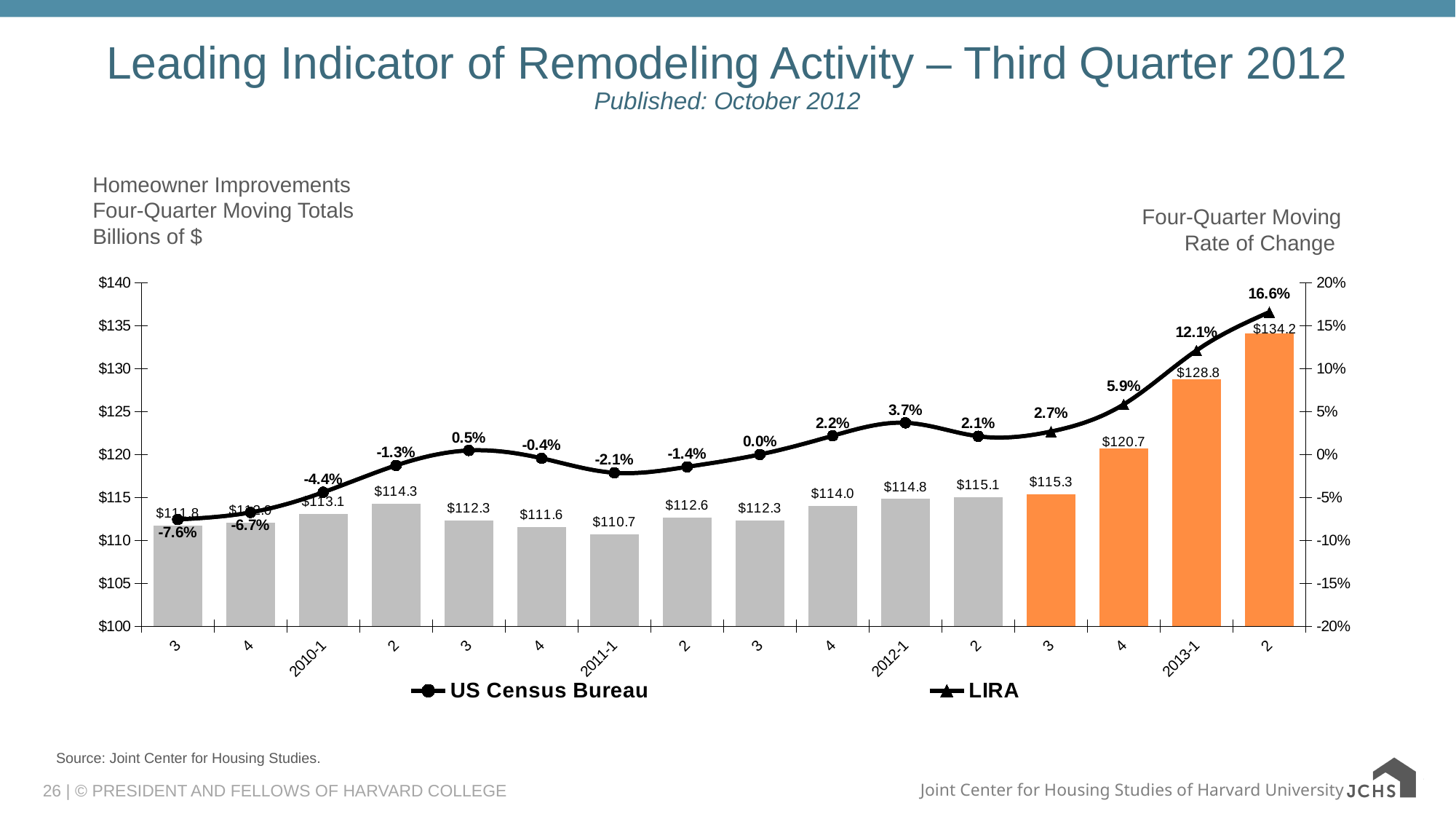
How many series does the legend list? 2 What is the four-quarter moving total shown for 2013-1? $128.8 What four-quarter moving rate of change is labeled at 2012-1? 3.7% What are the two legend entries on the chart? US Census Bureau and LIRA What is the highest four-quarter moving total value labeled on any bar? $134.2 What is the lowest four-quarter moving rate of change labeled on the line? -7.6% Which quarter has the lowest four-quarter moving total bar? 2011-1 ($110.7) How many bars are plotted on the chart? 16 Which bar is taller: 2010-1 or 2012-1? 2012-1 Does the rate of change line rise or fall over the last four quarters (2012 Q3 to 2013 Q2)? Rise What is the difference between the last bar ($134.2) and the 2013-1 bar ($128.8)? $5.4 What kind of chart is this? Combined bar and line chart